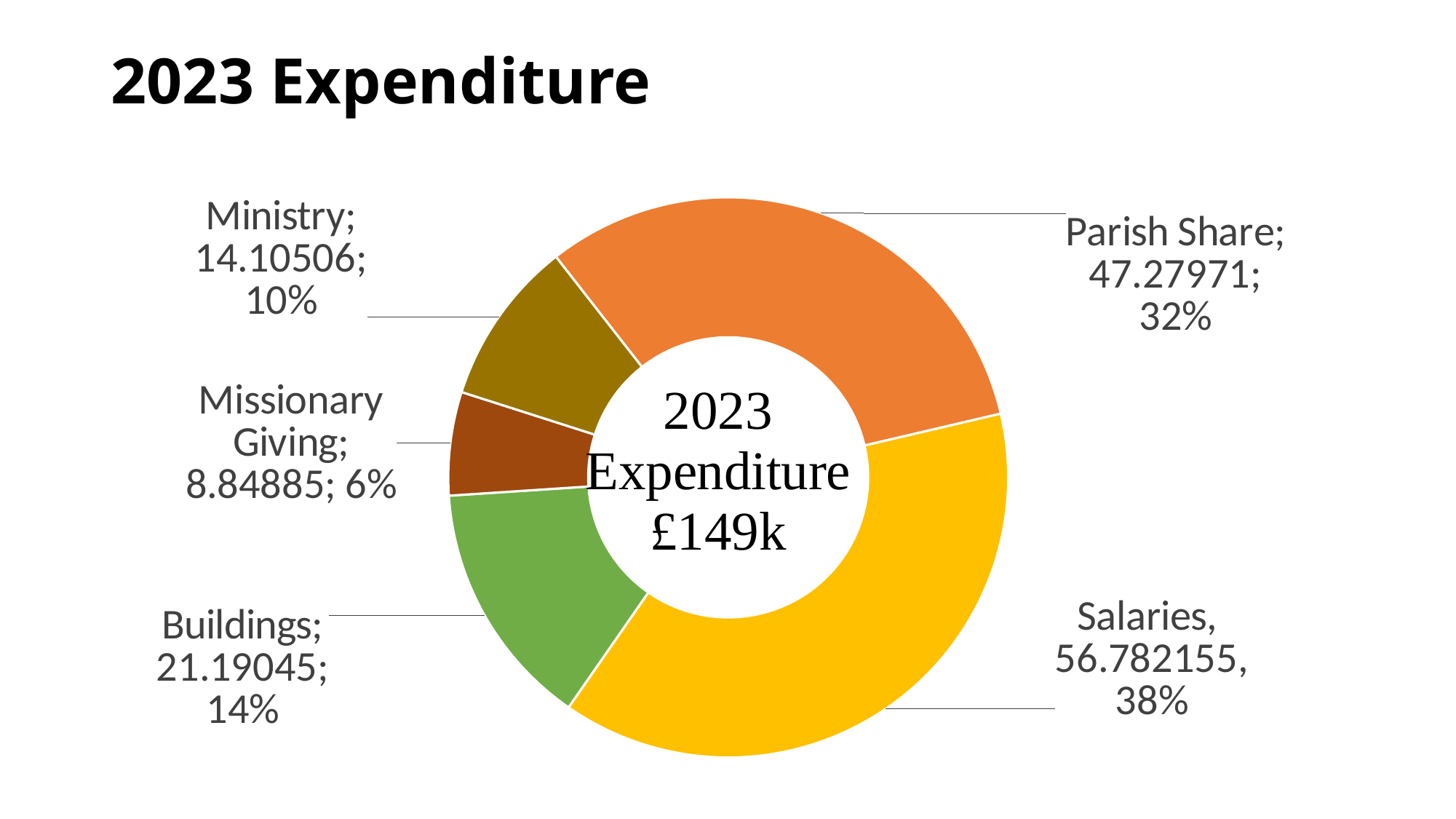
What percentage share does Ministry have? 10% What type of chart is shown on the slide? Doughnut (pie) chart What value is shown for Missionary Giving? 8.84885 Which category has the smallest share of expenditure? Missionary Giving What value is shown for Parish Share? 47.27971 How many categories are shown in the chart? 5 Which is larger, Parish Share or Buildings? Parish Share Which category has the largest share of expenditure? Salaries What total expenditure is shown in the centre of the chart? £149k What percentage share does Salaries have? 38% What value is shown for Salaries? 56.782155 What value is shown for Buildings? 21.19045